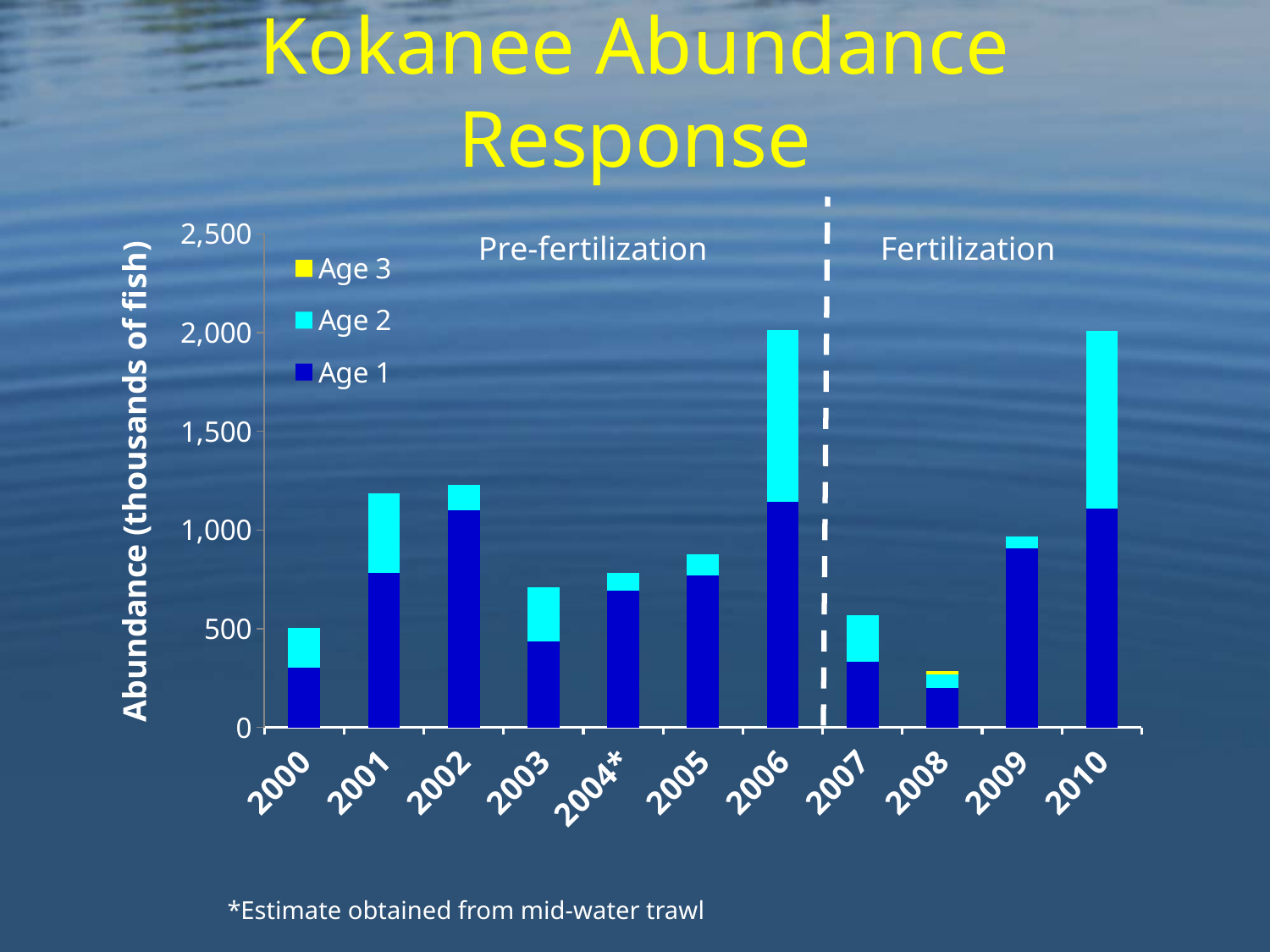
Is the total abundance for 2001 greater or less than 1,000? greater Is the Age 1 abundance for 2002 greater or less than 1,000? greater How many series does the chart's legend list? 3 Which year has the lowest total kokanee abundance? 2008 Which series in the legend is shown in yellow? Age 3 What kind of chart is shown on the slide? Stacked bar chart Is the total abundance for 2010 greater or less than 1,500? greater Which year has the larger total abundance, 2001 or 2003? 2001 What is the label on the y axis of the chart? Abundance (thousands of fish) How many years are shown along the x axis of the chart? 11